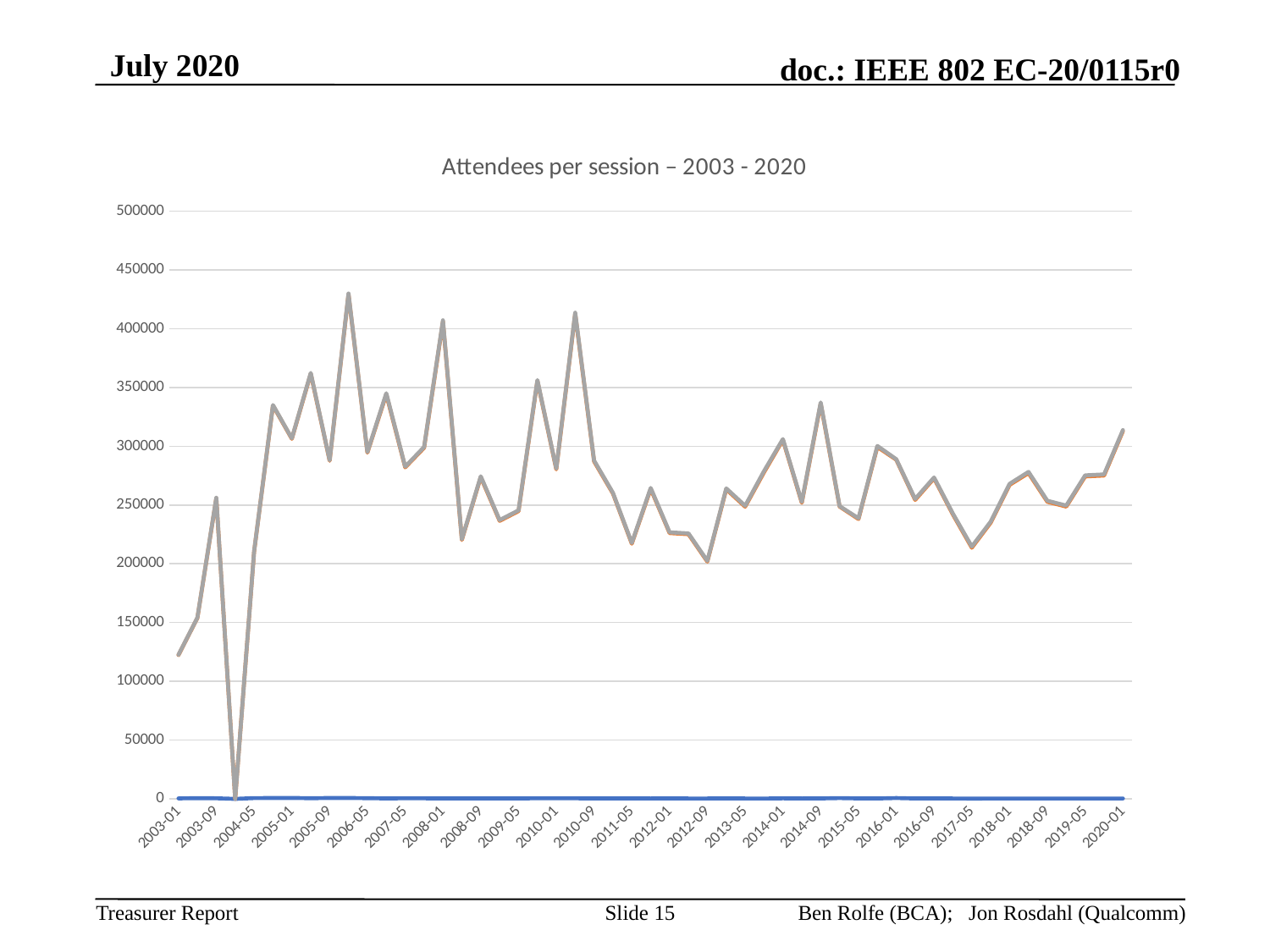
What is the title of the chart? Attendees per session – 2003 - 2020 What kind of chart is shown on the slide? line chart Which has the larger value, 2008-01 or 2017-05? 2008-01 Is the value for 2008-01 greater or less than 350000? greater Is the value for 2020-01 greater or less than 300000? greater Is the value for 2014-09 greater or less than 300000? greater Does the line rise or fall between 2014-09 and 2015-05? fall Which has the larger value, 2003-01 or 2020-01? 2020-01